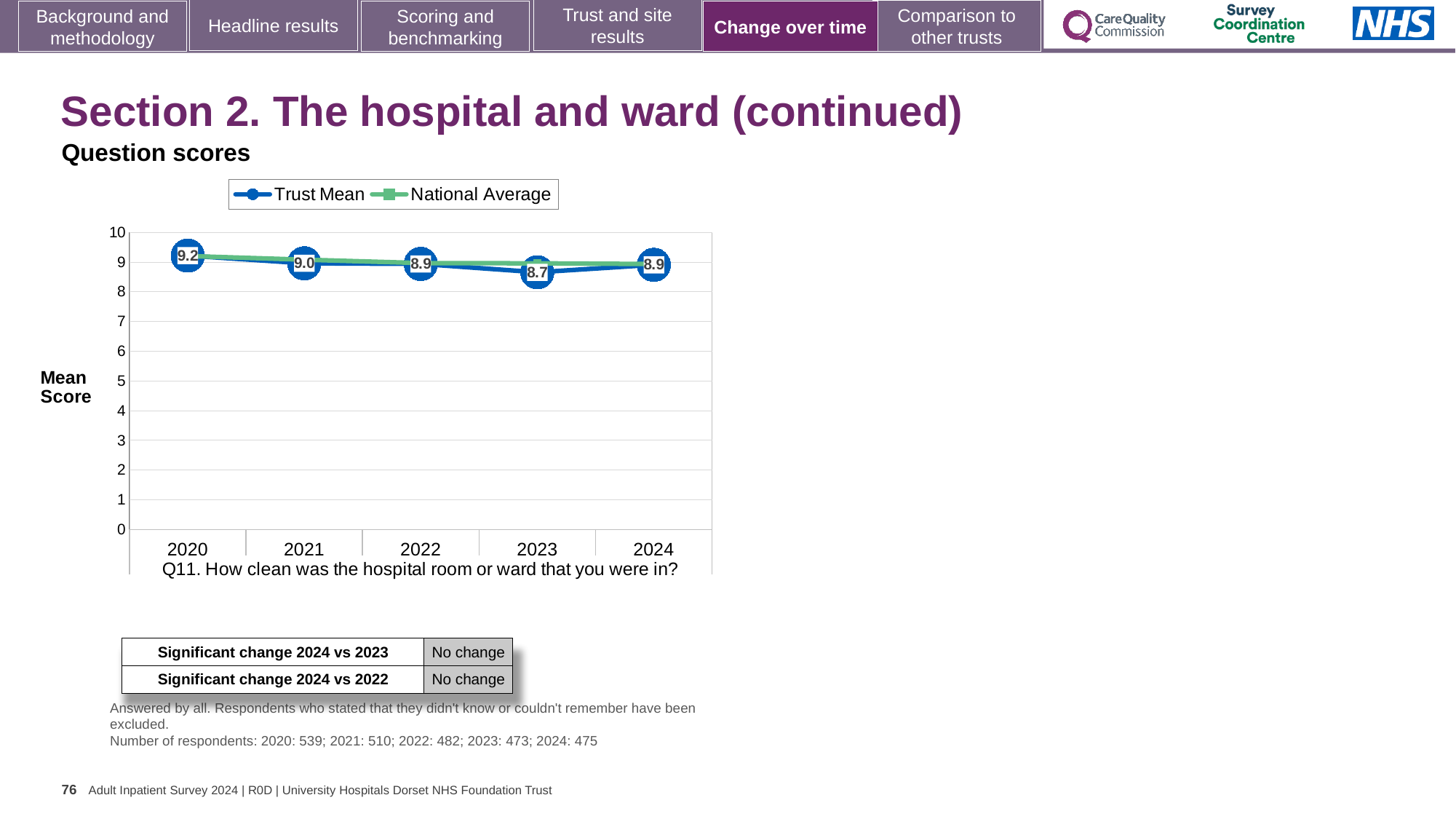
What is the difference between the Trust Mean in 2020 and in 2023? 0.5 What is the Trust Mean for 2024? 8.9 Does the Trust Mean rise or fall from 2020 to 2023? Fall In which year is the Trust Mean lowest? 2023 How many series does the legend list? 2 Which year has the larger Trust Mean, 2021 or 2023? 2021 How many years are shown on the x axis? 5 What kind of chart is shown? Line chart What is the Trust Mean for 2020? 9.2 In which year is the Trust Mean highest? 2020 Is the National Average for 2023 greater or less than 8? greater What is the Trust Mean for 2023? 8.7